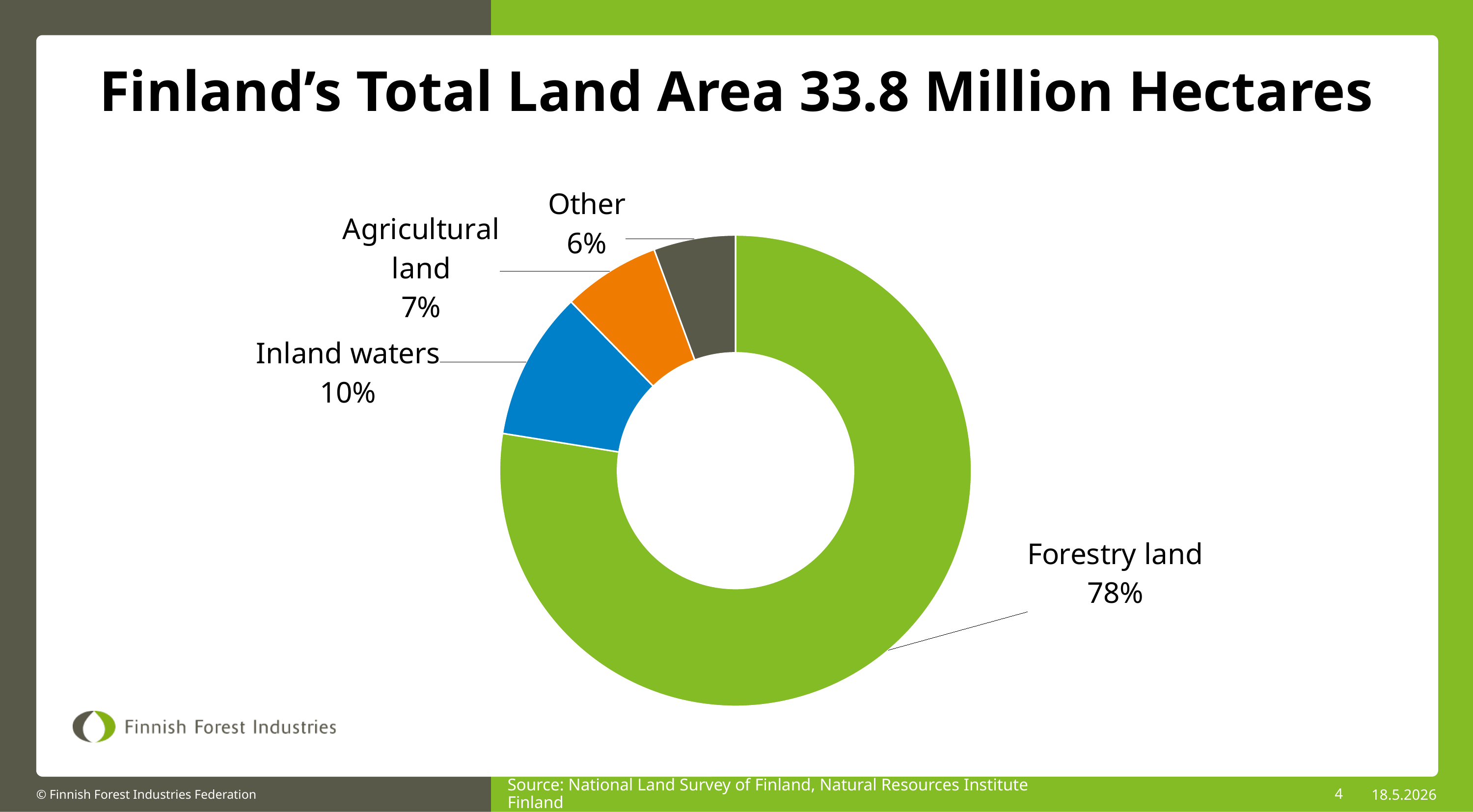
What kind of chart is shown on the slide? Pie chart (doughnut) What is the difference in percentage points between Forestry land and Inland waters? 68 Which category has the largest share of the chart? Forestry land Which is larger, the share for Inland waters or the share for Agricultural land? Inland waters Which category has the smallest share of the chart? Other What share of Finland's total land area is Forestry land? 78% What share of Finland's total land area is labelled Other? 6% What share of Finland's total land area is Inland waters? 10% How many categories are shown in the chart? 4 What is the title of the slide? Finland's Total Land Area 33.8 Million Hectares What is the difference in percentage points between Agricultural land and Other? 1 What share of Finland's total land area is Agricultural land? 7%